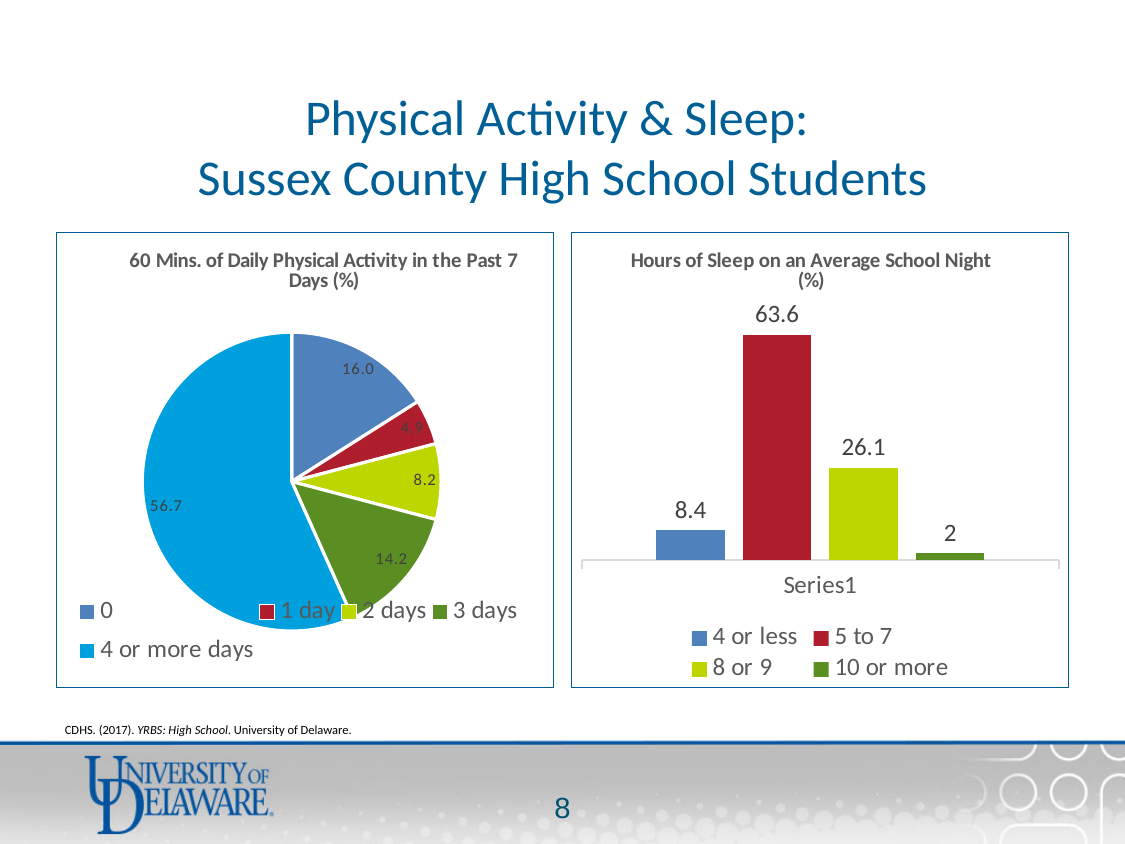
In the '60 Mins. of Daily Physical Activity in the Past 7 Days (%)' pie chart, what is the difference between the values for '3 days' and '2 days'? 6.0 In the '60 Mins. of Daily Physical Activity in the Past 7 Days (%)' pie chart, which category has the smallest slice? 1 day In the 'Hours of Sleep on an Average School Night (%)' chart, which is larger: the value for '4 or less' or the value for '8 or 9'? 8 or 9 In the '60 Mins. of Daily Physical Activity in the Past 7 Days (%)' pie chart, which category has the largest slice? 4 or more days In the 'Hours of Sleep on an Average School Night (%)' chart, what is the value for '5 to 7' hours? 63.6 What kind of chart is the 'Hours of Sleep on an Average School Night (%)' chart? bar chart In the '60 Mins. of Daily Physical Activity in the Past 7 Days (%)' pie chart, how many categories are shown? 5 In the 'Hours of Sleep on an Average School Night (%)' chart, what is the value for '10 or more' hours? 2 In the 'Hours of Sleep on an Average School Night (%)' chart, which category has the highest value? 5 to 7 In the 'Hours of Sleep on an Average School Night (%)' chart, what is the difference between the values for '5 to 7' and '8 or 9'? 37.5 In the '60 Mins. of Daily Physical Activity in the Past 7 Days (%)' pie chart, what is the value for '4 or more days'? 56.7 In the '60 Mins. of Daily Physical Activity in the Past 7 Days (%)' pie chart, what is the value for '0' days? 16.0